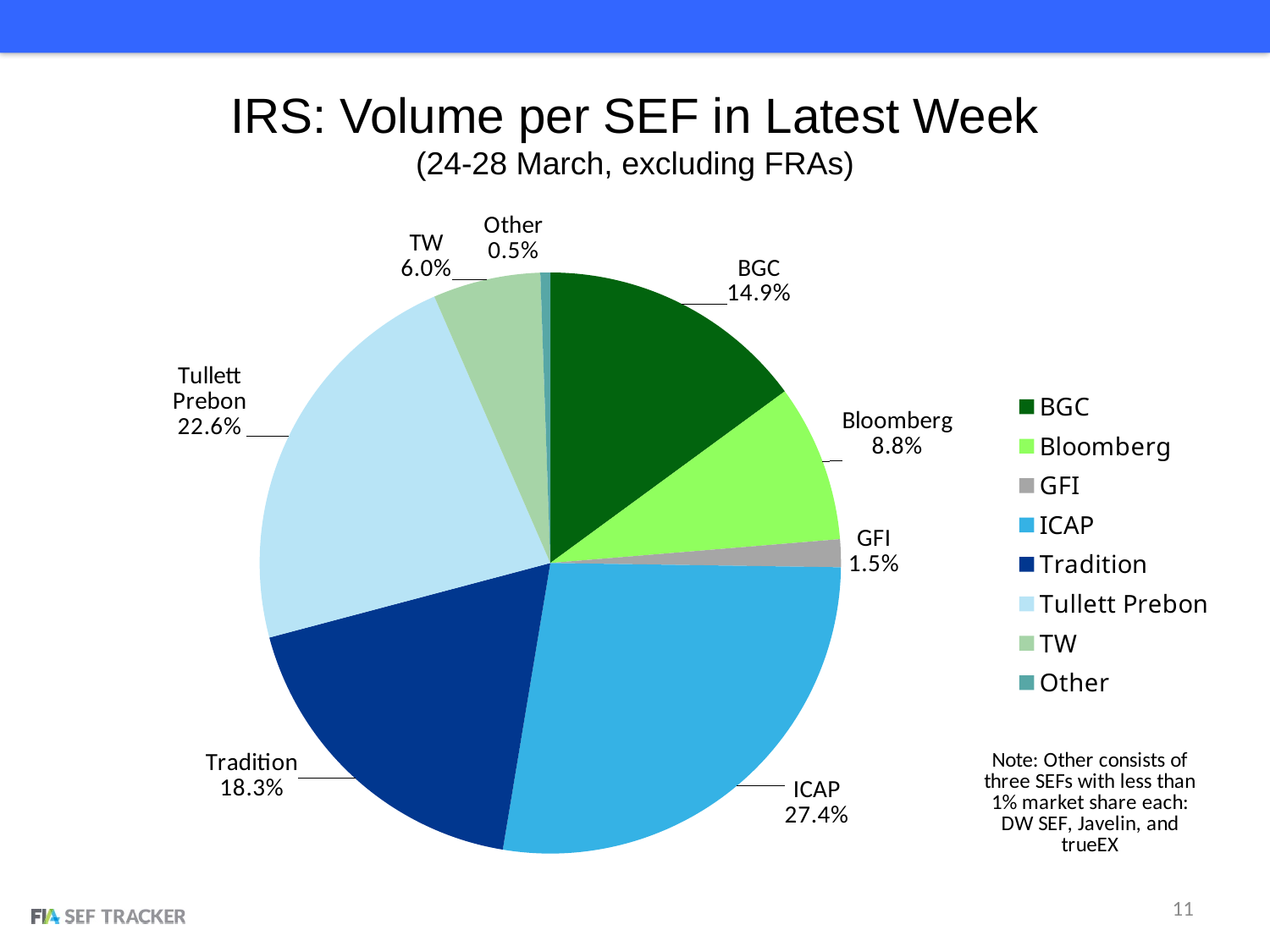
What is the title of the chart? IRS: Volume per SEF in Latest Week What share of IRS volume does ICAP have in the latest week? 27.4% Which has a larger share, BGC or Bloomberg? BGC What is the value shown for Tullett Prebon? 22.6% What is the difference between the shares of ICAP and Tradition? 9.1% What kind of chart is shown on the slide? pie chart What is the combined share of TW and Other? 6.5% How many slices does the pie chart have? 8 How many entries does the legend list? 8 Which slice of the pie is the smallest? Other Which SEF has the largest share of the pie? ICAP What percentage is shown for GFI? 1.5%